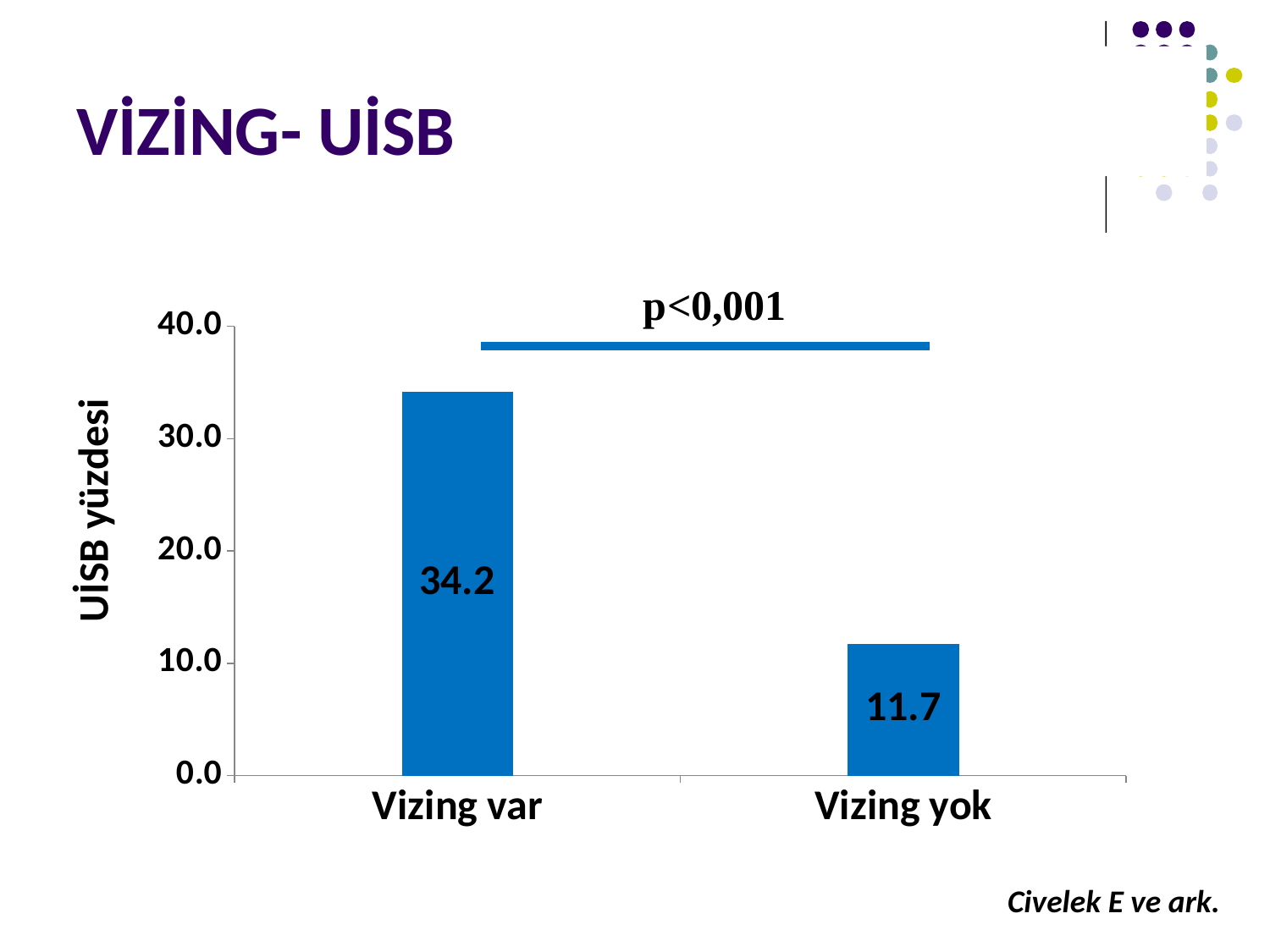
Is the value for Vizing yok greater or less than 20.0? less How many categories are shown on the x axis? 2 What is the label of the y axis? UİSB yüzdesi What is the difference between the values for Vizing var and Vizing yok? 22.5 Is the value for Vizing var greater or less than 30.0? greater Which is larger, the value for Vizing var or the value for Vizing yok? Vizing var Which category has the highest UİSB yüzdesi? Vizing var Which category has the lowest UİSB yüzdesi? Vizing yok What kind of chart is shown on the slide? bar chart What is the UİSB yüzdesi value for Vizing var? 34.2 What is the UİSB yüzdesi value for Vizing yok? 11.7 What p-value is shown above the bars? p<0,001